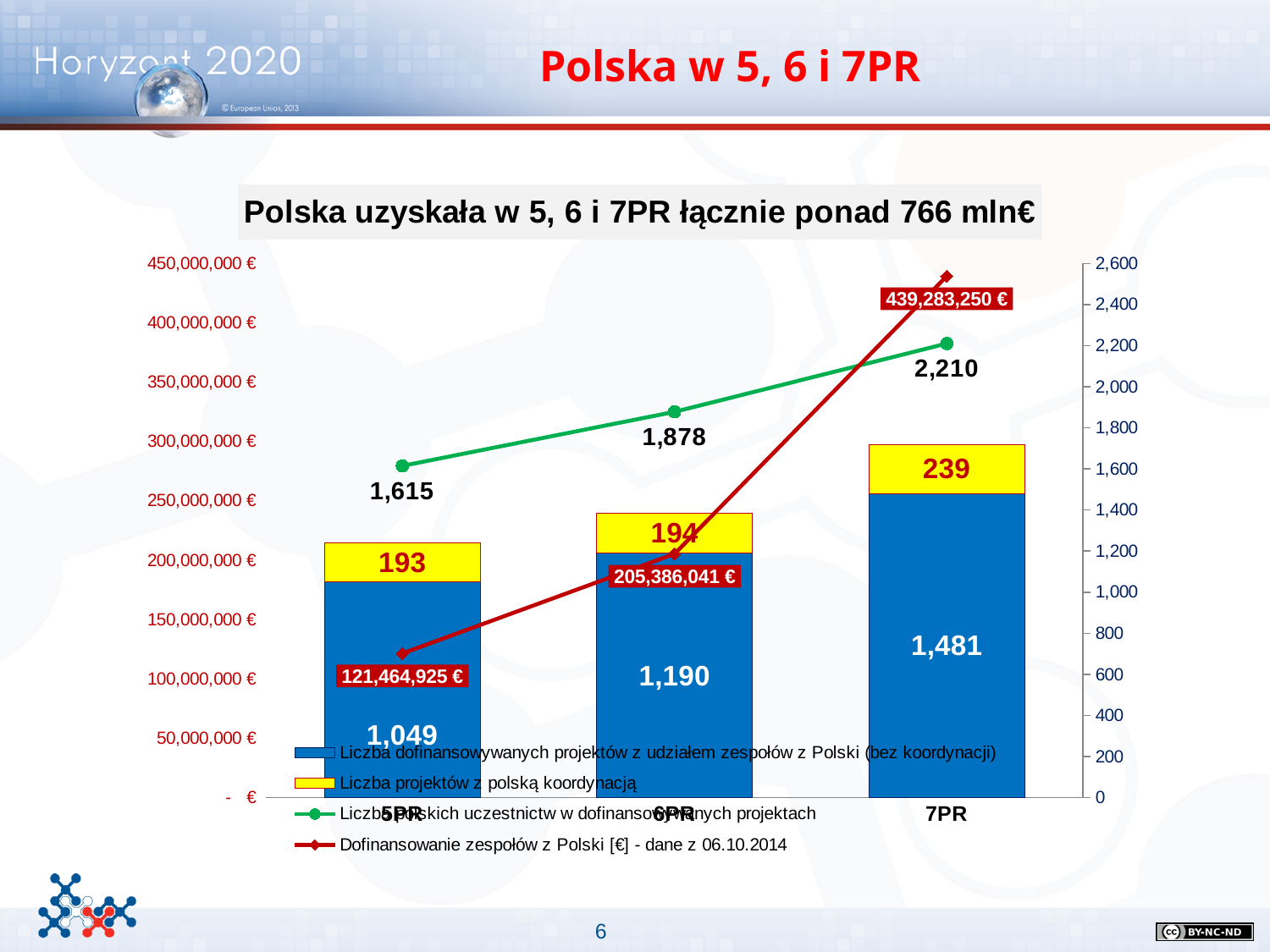
What is the value of 'Liczba dofinansowywanych projektów z udziałem zespołów z Polski (bez koordynacji)' for 5PR? 1,049 What is the total height of the stacked bar for 6PR (both bar series combined)? 1,384 Is the 'Liczba dofinansowywanych projektów z udziałem zespołów z Polski (bez koordynacji)' value larger for 6PR or 7PR? 7PR What is the value of 'Liczba projektów z polską koordynacją' for 7PR? 239 What is the difference between the 'Liczba polskich uczestnictw w dofinansowanych projektach' values for 7PR and 5PR? 595 What is the value of 'Dofinansowanie zespołów z Polski [€]' for 5PR? 121,464,925 € Does the 'Dofinansowanie zespołów z Polski [€]' line rise or fall from 5PR to 7PR? rise What is the value of 'Dofinansowanie zespołów z Polski [€]' for 7PR? 439,283,250 € How many series does the legend list? 4 How many 'Liczba polskich uczestnictw w dofinansowanych projektach' are shown for 6PR? 1,878 Which programme has the lowest number of 'Liczba polskich uczestnictw w dofinansowanych projektach'? 5PR Which programme has the highest value for 'Dofinansowanie zespołów z Polski [€]'? 7PR